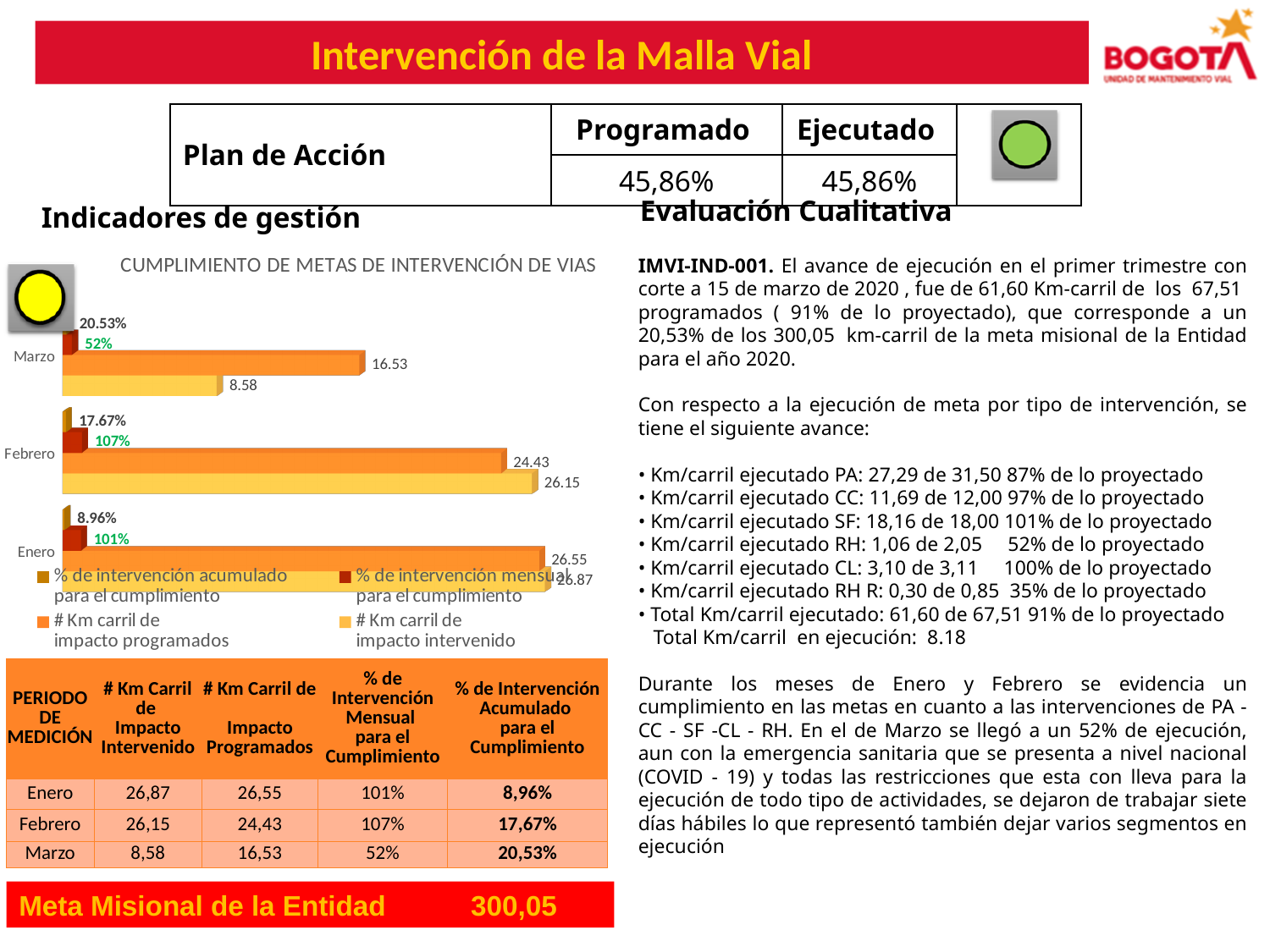
What is the value of '# Km carril de impacto programados' for Marzo? 16.53 What type of chart is shown under 'Indicadores de gestión'? bar chart Which month has the lowest '% de intervención mensual para el cumplimiento'? Marzo Which month has the highest '# Km carril de impacto intervenido'? Enero What is the difference between '# Km carril de impacto programados' and '# Km carril de impacto intervenido' for Marzo? 7.95 How many periods (categories) are shown on the chart? 3 How many series does the chart legend list? 4 What is the '% de intervención mensual para el cumplimiento' for Enero? 101% What is the value of '# Km carril de impacto intervenido' for Febrero? 26.15 What is the '% de intervención acumulado para el cumplimiento' for Marzo? 20.53% Is '# Km carril de impacto intervenido' larger for Febrero or for Marzo? Febrero What is the title of the chart on the slide? CUMPLIMIENTO DE METAS DE INTERVENCIÓN DE VIAS